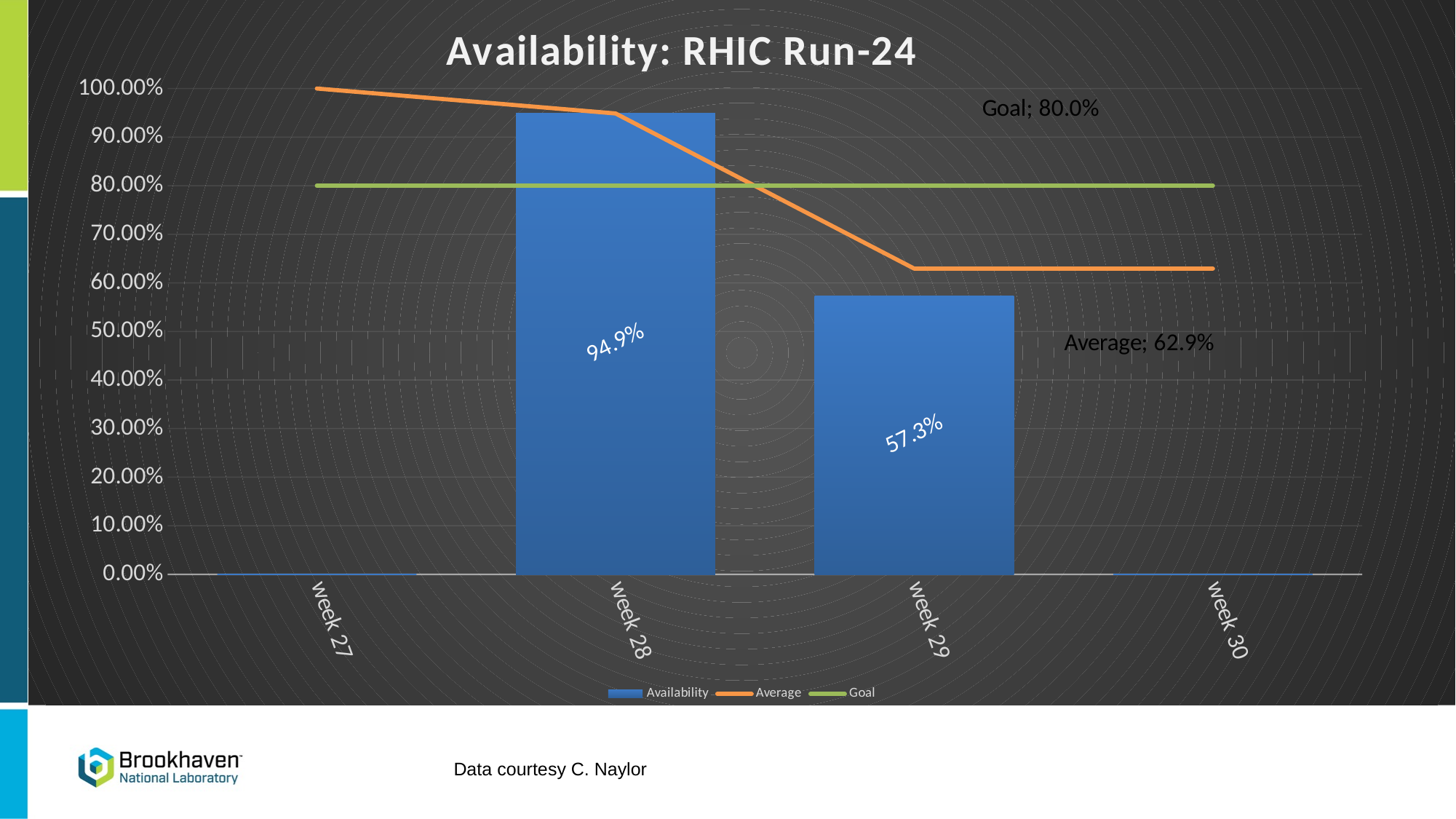
What kind of chart is this? bar chart with line series How many week categories are shown on the x axis? 4 Which week has the highest availability bar? week 28 Which is larger, the availability for week 28 or the Goal value? week 28 Is the availability for week 29 greater or less than 60.00%? less Does the Average line rise or fall from week 27 to week 29? fall What is the availability value for week 28? 94.9% What value is labelled for the Goal line? 80.0% How many series does the legend list? 3 What value is labelled for the Average line? 62.9% What is the availability value for week 29? 57.3% What is the difference between the availability for week 28 and week 29? 37.6 percentage points